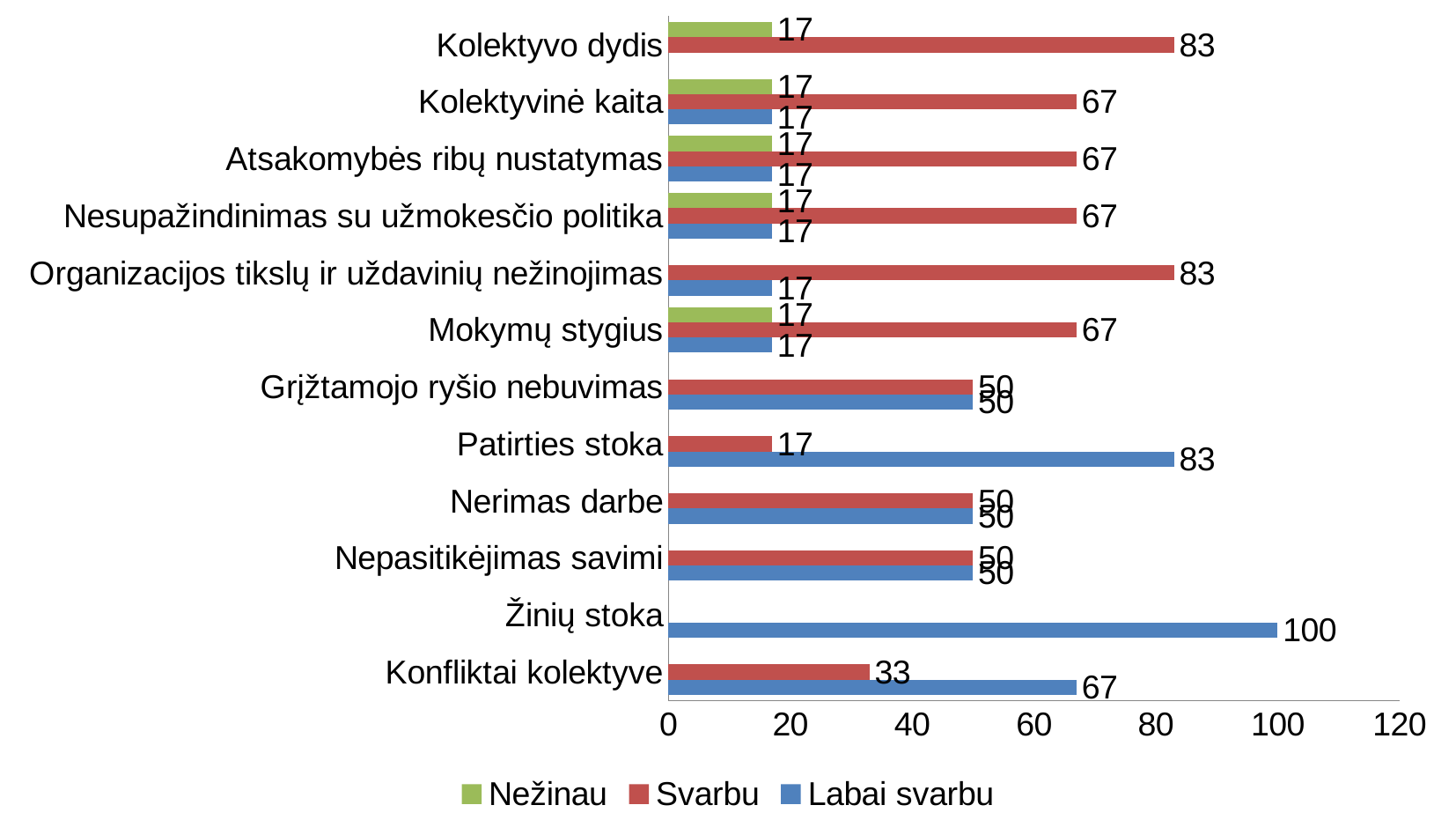
How many series does the legend list? 3 Is the Svarbu value for Mokymų stygius greater or less than 60? greater How many categories are shown on the chart? 12 What is the Svarbu value for Konfliktai kolektyve? 33 What kind of chart is shown on the slide? Bar chart For Patirties stoka, which is larger: the Svarbu value or the Labai svarbu value? Labai svarbu Which series is shown in green? Nežinau What is the Labai svarbu value for Patirties stoka? 83 What is the Labai svarbu value for Žinių stoka? 100 What is the Svarbu value for Kolektyvo dydis? 83 Which category has the highest Labai svarbu value? Žinių stoka What is the difference between the Svarbu and Labai svarbu values for Konfliktai kolektyve? 34